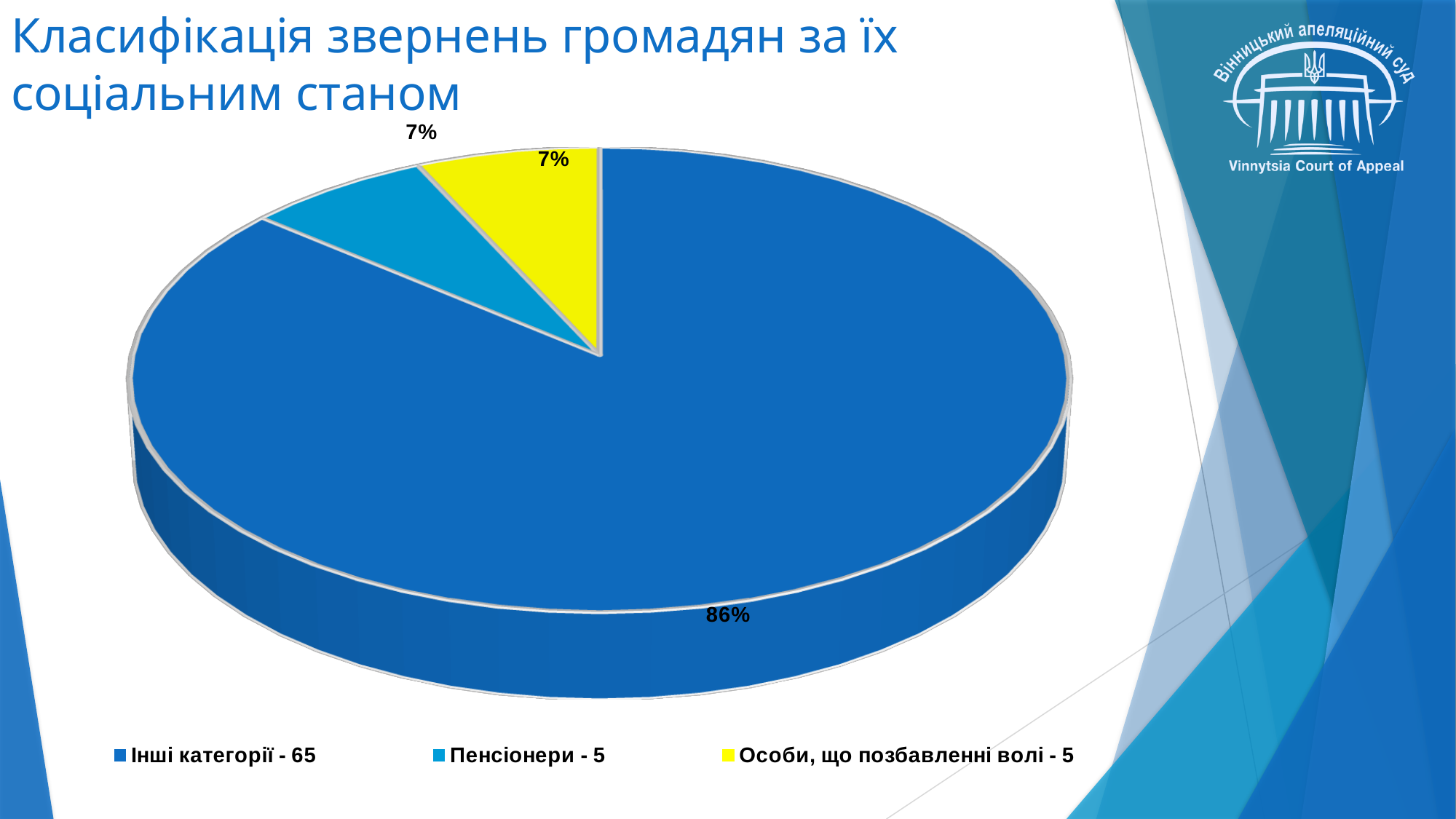
What count is given in the legend for "Пенсіонери"? 5 What count is given in the legend for "Інші категорії"? 65 What percentage share does the slice "Пенсіонери" have? 7% Which is larger, the share for "Інші категорії" or the share for "Пенсіонери"? Інші категорії What count is given in the legend for "Особи, що позбавленні волі"? 5 How many slices does the pie chart have? 3 What percentage share does the slice "Інші категорії" have? 86% What colour is the slice for "Особи, що позбавленні волі"? yellow What percentage share does the slice "Особи, що позбавленні волі" have? 7% Which category has the largest slice of the pie? Інші категорії What kind of chart is shown on the slide? pie chart What is the difference between the counts for "Інші категорії" and "Пенсіонери" shown in the legend? 60